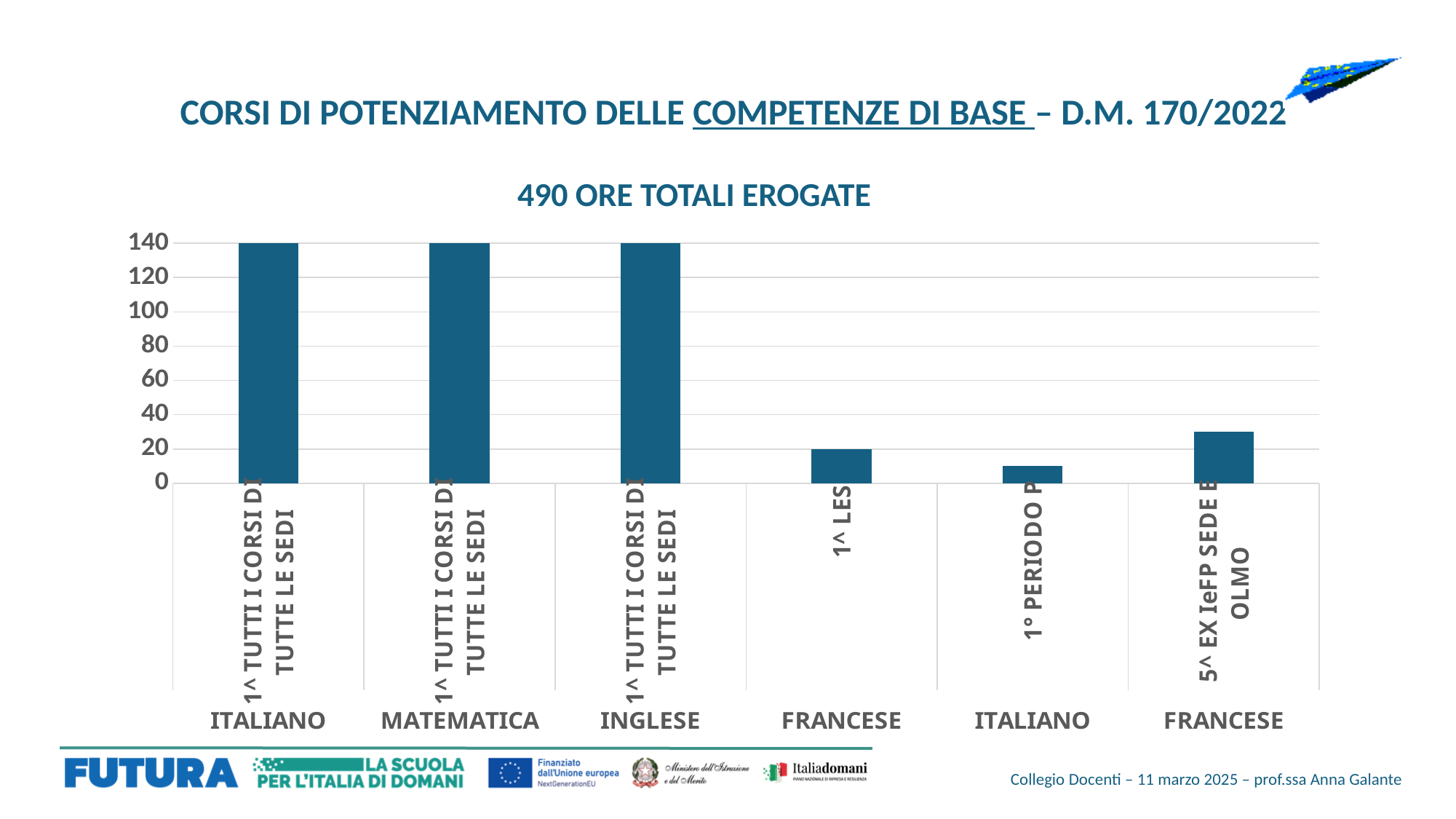
Which category has the lowest value? ITALIANO (1° PERIODO) What type of chart is shown on the slide? bar chart Is the value for ITALIANO (1° PERIODO) greater or less than 20? less What is the value for MATEMATICA (1^ TUTTI I CORSI DI TUTTE LE SEDI)? 140 What is the title of the chart? 490 ORE TOTALI EROGATE How many bars are plotted in the chart? 6 Which is larger, the value for MATEMATICA (1^ TUTTI I CORSI DI TUTTE LE SEDI) or the value for FRANCESE (1^ LES)? MATEMATICA (1^ TUTTI I CORSI DI TUTTE LE SEDI) Is the value for FRANCESE (5^ EX IeFP SEDE OLMO) greater or less than 40? less What is the value for INGLESE (1^ TUTTI I CORSI DI TUTTE LE SEDI)? 140 What is the value for FRANCESE (1^ LES)? 20 What is the difference between the value for INGLESE (1^ TUTTI I CORSI DI TUTTE LE SEDI) and the value for FRANCESE (1^ LES)? 120 What is the value for ITALIANO (1^ TUTTI I CORSI DI TUTTE LE SEDI)? 140